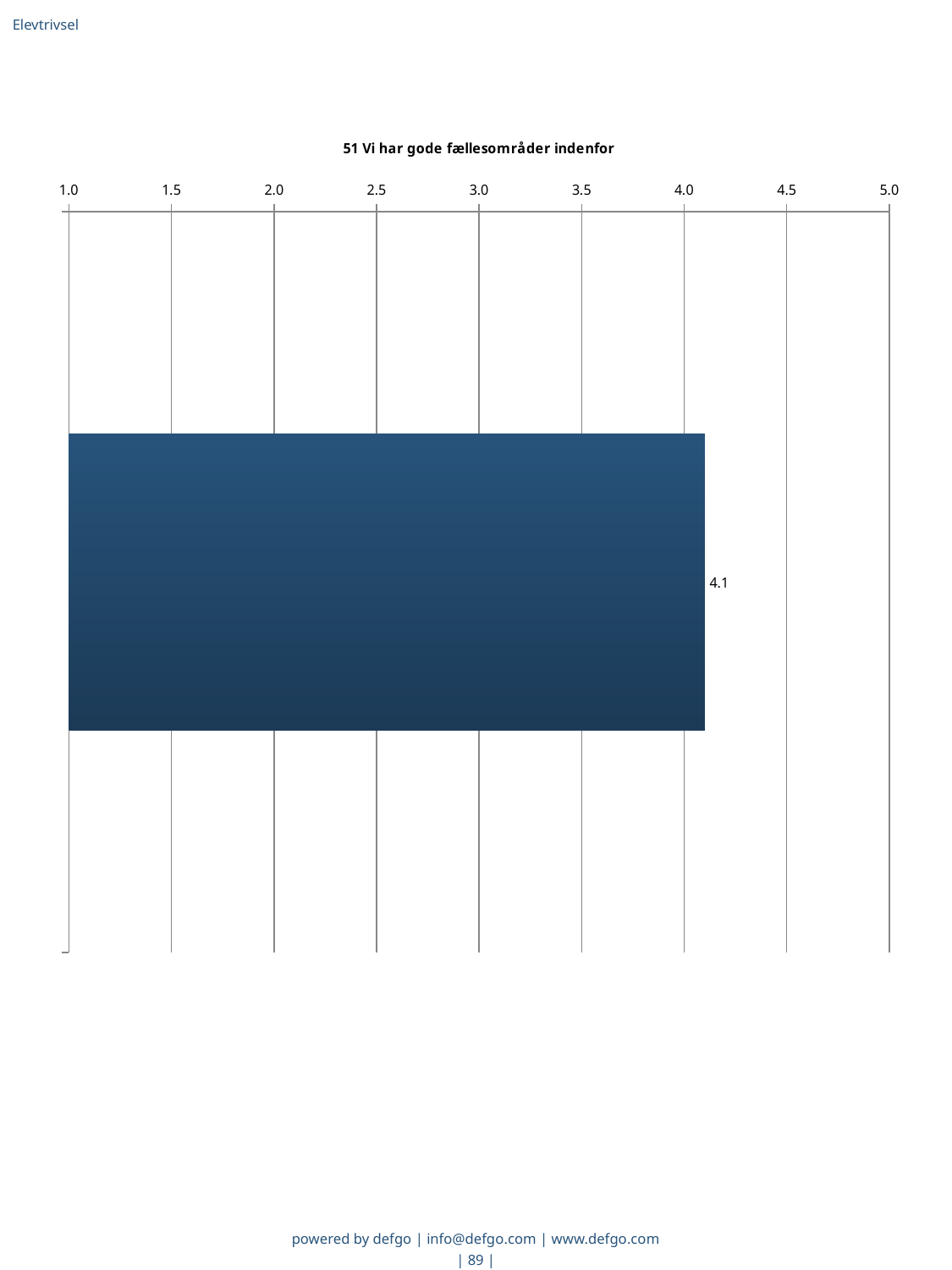
Is the value of the bar greater or less than 4.5? less What kind of chart is shown on the slide? bar chart What is the title of the chart? 51 Vi har gode fællesområder indenfor What is the value shown by the bar in the chart titled "51 Vi har gode fællesområder indenfor"? 4.1 Is the value of the bar greater or less than 4.0? greater Is the bar in the chart horizontal or vertical? horizontal How many bars are plotted in the chart? 1 What is the maximum value shown on the chart's axis? 5.0